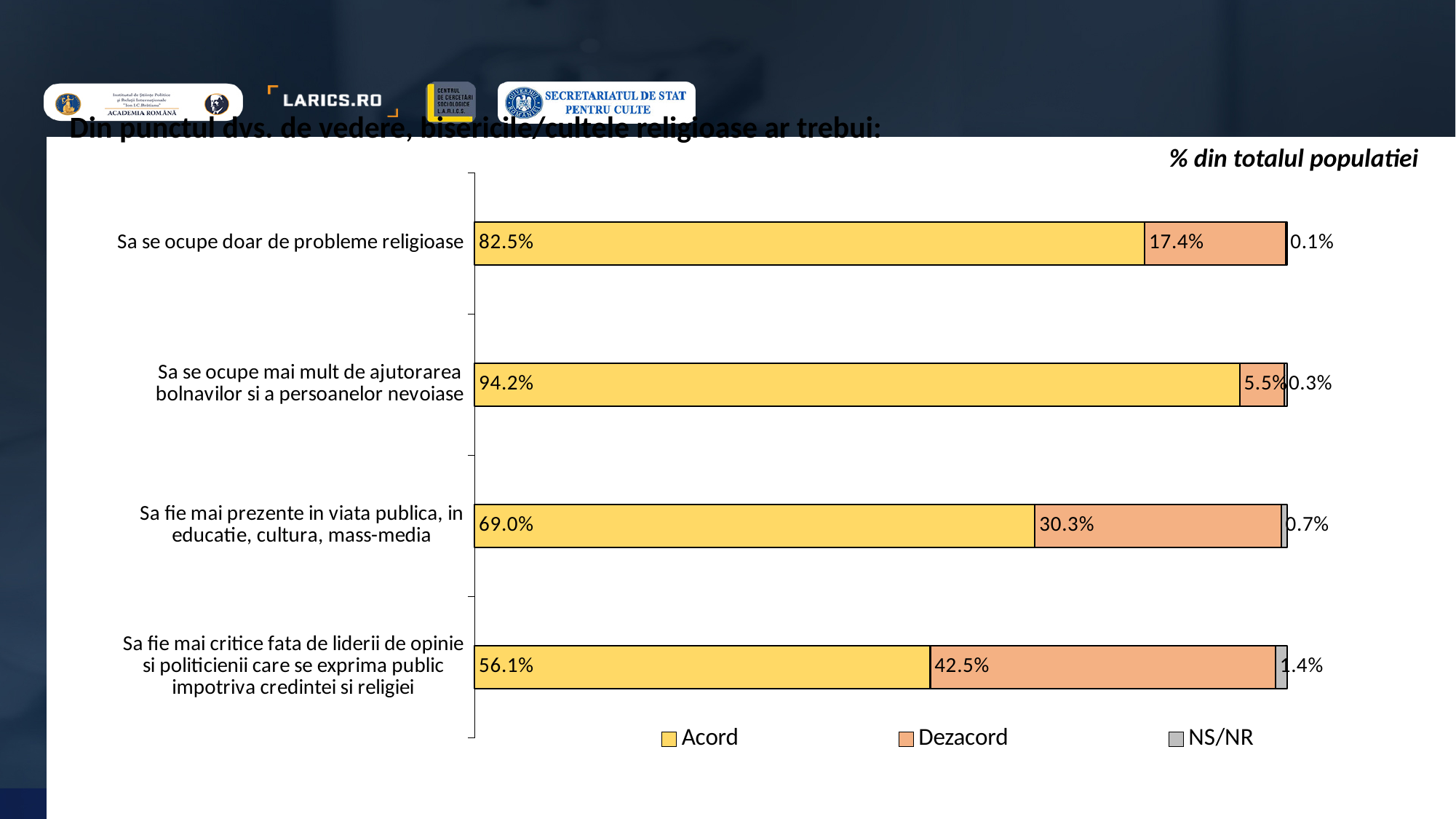
Which category has the highest Acord value? Sa se ocupe mai mult de ajutorarea bolnavilor si a persoanelor nevoiase How many categories are shown in the chart? 4 What is the NS/NR value for "Sa fie mai critice fata de liderii de opinie si politicienii care se exprima public impotriva credintei si religiei"? 1.4% What is the Dezacord value for "Sa fie mai prezente in viata publica, in educatie, cultura, mass-media"? 30.3% Which series is shown in grey in the legend? NS/NR What is the difference between the Acord values for "Sa se ocupe doar de probleme religioase" and "Sa fie mai prezente in viata publica, in educatie, cultura, mass-media"? 13.5% What is the Acord value for "Sa se ocupe doar de probleme religioase"? 82.5% Which category has the lowest Acord value? Sa fie mai critice fata de liderii de opinie si politicienii care se exprima public impotriva credintei si religiei What is the total of the stacked bar for "Sa fie mai prezente in viata publica, in educatie, cultura, mass-media"? 100.0% Which is larger: the Dezacord value for "Sa se ocupe doar de probleme religioase" or for "Sa se ocupe mai mult de ajutorarea bolnavilor si a persoanelor nevoiase"? Sa se ocupe doar de probleme religioase What kind of chart is shown on the slide? Stacked bar chart How many series does the legend list? 3